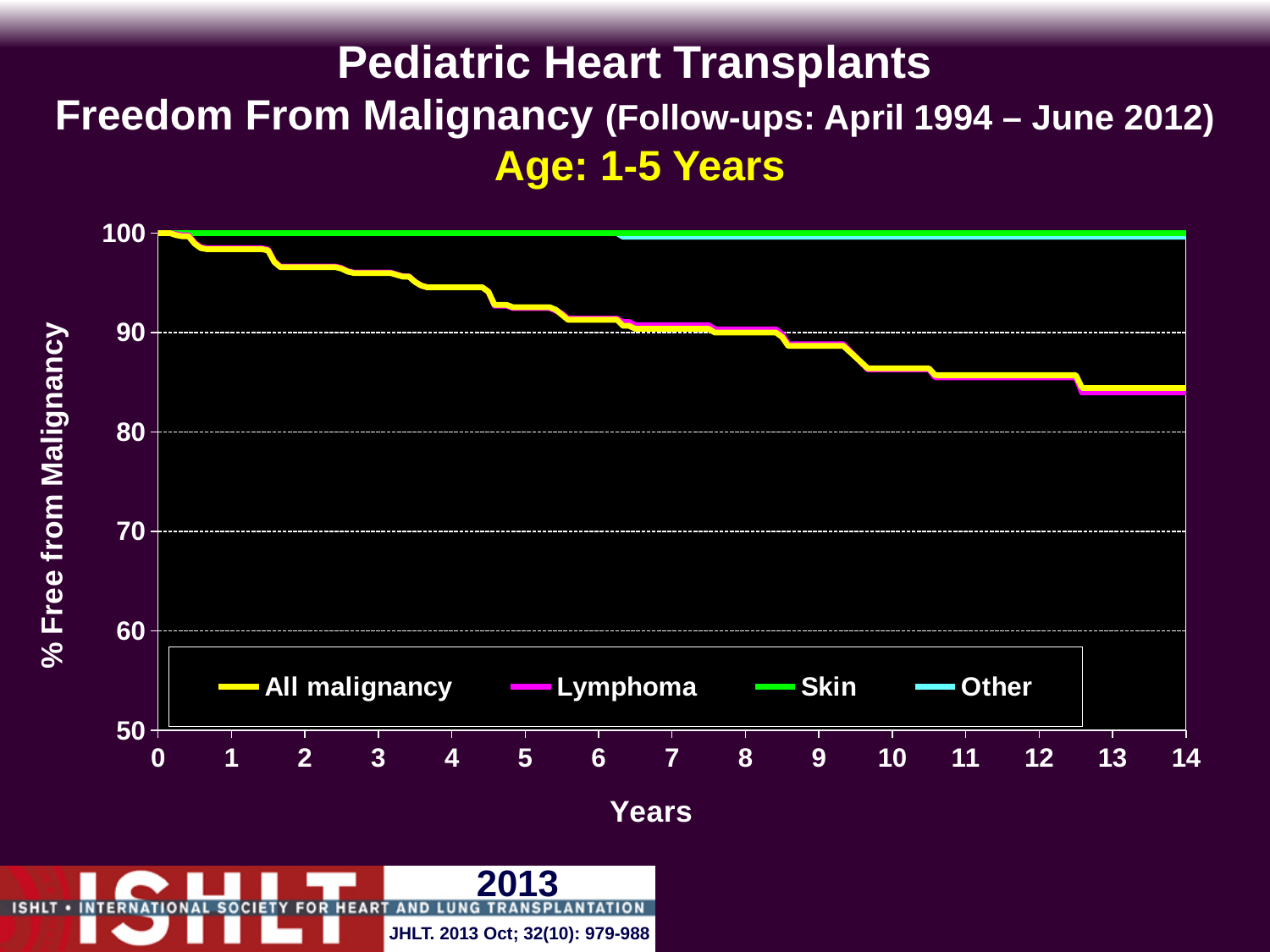
What is the highest value shown on the x axis? 14 How many series does the legend list? 4 Is the value for Lymphoma at 10 years greater or less than 90? less At 14 years, which is larger: the value for All malignancy or the value for Skin? Skin What is the label of the y axis? % Free from Malignancy Is the value for All malignancy at 14 years greater or less than 90? less Is the value for All malignancy at 2 years greater or less than 90? greater Does the All malignancy line rise or fall as the years increase? fall What kind of chart is shown on the slide? line chart Which series are listed in the legend? All malignancy, Lymphoma, Skin, Other